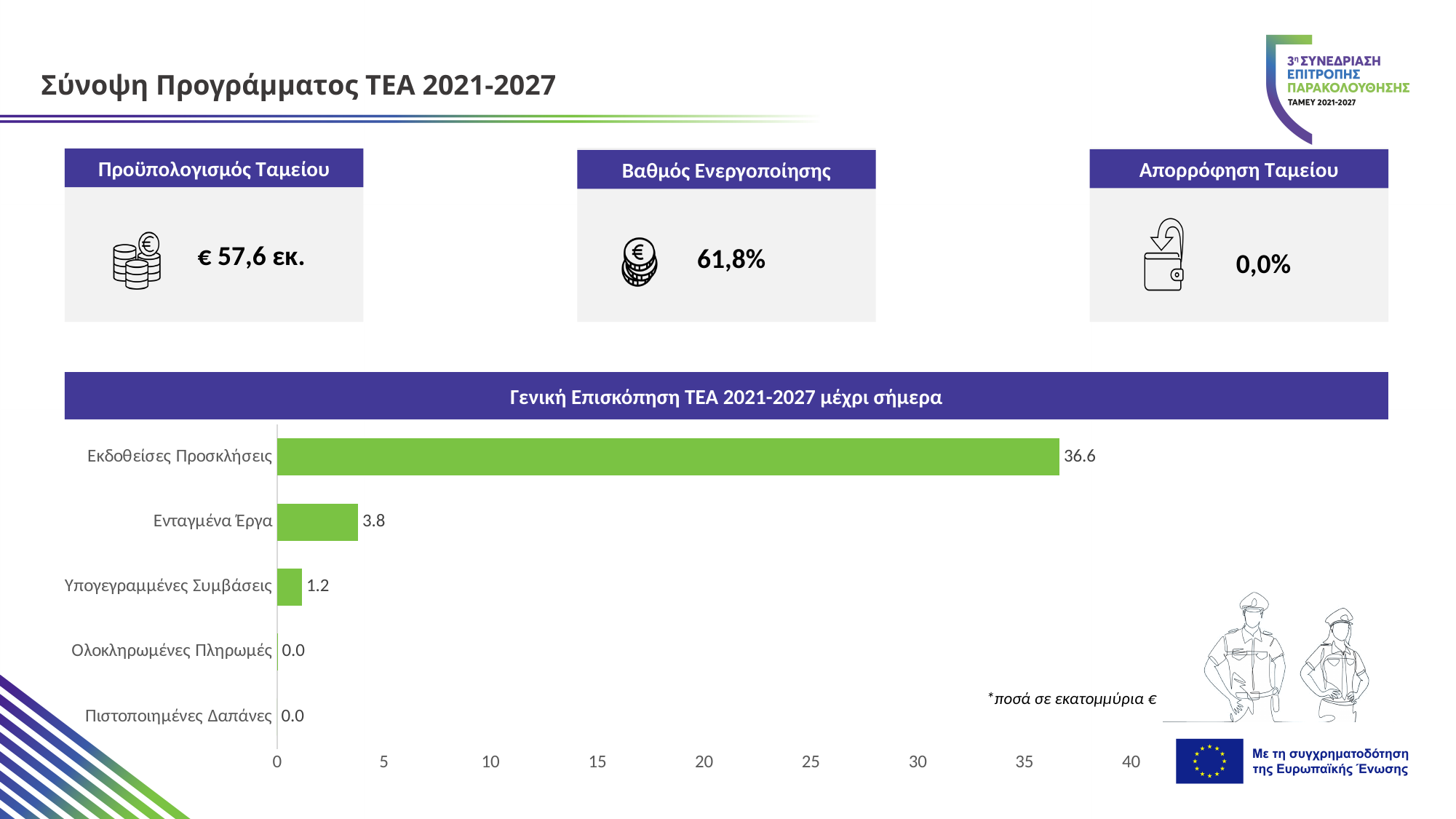
What is the value for 'Ενταγμένα Έργα' in the bar chart? 3.8 What is the difference between the values for 'Εκδοθείσες Προσκλήσεις' and 'Ενταγμένα Έργα' in the bar chart? 32.8 What is the value for 'Ολοκληρωμένες Πληρωμές' in the bar chart? 0.0 Which is larger in the bar chart: 'Ενταγμένα Έργα' or 'Υπογεγραμμένες Συμβάσεις'? Ενταγμένα Έργα What is the value for 'Πιστοποιημένες Δαπάνες' in the bar chart? 0.0 What type of chart is shown under the heading 'Γενική Επισκόπηση ΤΕΑ 2021-2027 μέχρι σήμερα'? Bar chart What is the value for 'Υπογεγραμμένες Συμβάσεις' in the bar chart? 1.2 What is the difference between the values for 'Ενταγμένα Έργα' and 'Υπογεγραμμένες Συμβάσεις' in the bar chart? 2.6 Which category has the highest value in the bar chart? Εκδοθείσες Προσκλήσεις What is the value for 'Εκδοθείσες Προσκλήσεις' in the bar chart? 36.6 Is the value for 'Εκδοθείσες Προσκλήσεις' greater or less than 35? greater How many categories are shown in the bar chart? 5